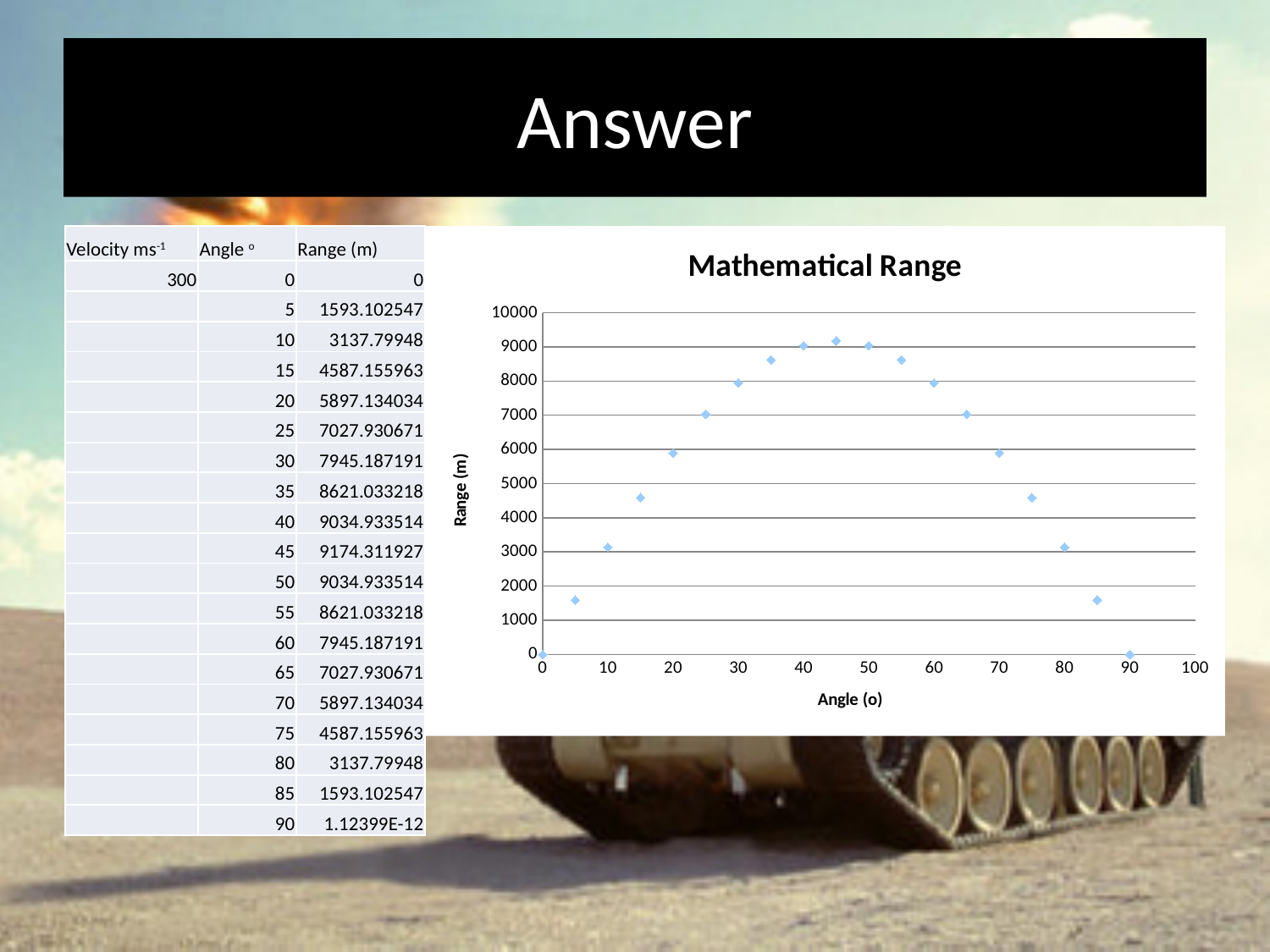
What kind of chart is shown on the slide? scatter chart At which angle is the plotted range highest? 45 Is the range at an angle of 20 degrees greater or less than 5000? greater What is the label of the y axis of the chart? Range (m) Is the range at an angle of 85 degrees greater or less than 2000? less How many data points are plotted on the chart? 19 How do the plotted range values change as the angle increases from 0 to 90? They rise to a peak at 45 and then fall What is the title of the chart? Mathematical Range Which has the larger range, an angle of 40 degrees or an angle of 75 degrees? 40 degrees What is the difference between the range at 45 degrees and the range at 40 degrees? 139.378413 What is the range at an angle of 30 degrees? 7945.187191 What is the range at an angle of 45 degrees? 9174.311927